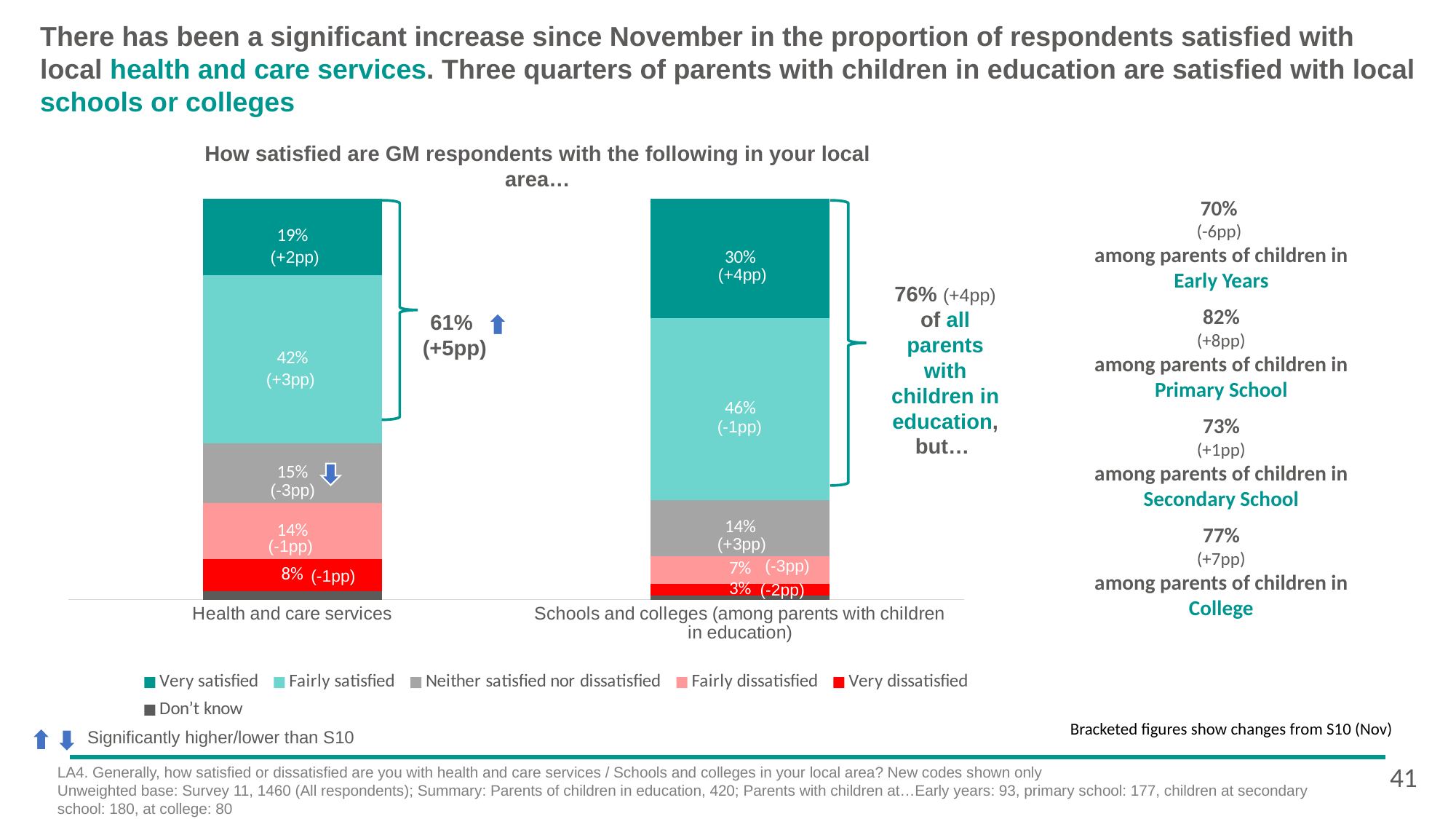
What is the change from S10 shown in brackets for the fairly satisfied segment of health and care services? +3pp What is the combined satisfied (very plus fairly) figure shown for health and care services? 61% What percentage of respondents are very satisfied with health and care services? 19% What kind of chart is shown? Stacked bar chart What percentage of parents with children in education are fairly satisfied with schools and colleges? 46% How many series does the legend list? 6 What percentage of parents with children in education are neither satisfied nor dissatisfied with schools and colleges? 14% How many categories are plotted on the x axis? 2 Which category has the higher very satisfied share: health and care services or schools and colleges? Schools and colleges Which colour represents the very dissatisfied series in the legend? Red What is the difference in the very satisfied share between schools and colleges and health and care services? 11 percentage points What percentage of respondents are very dissatisfied with health and care services? 8%